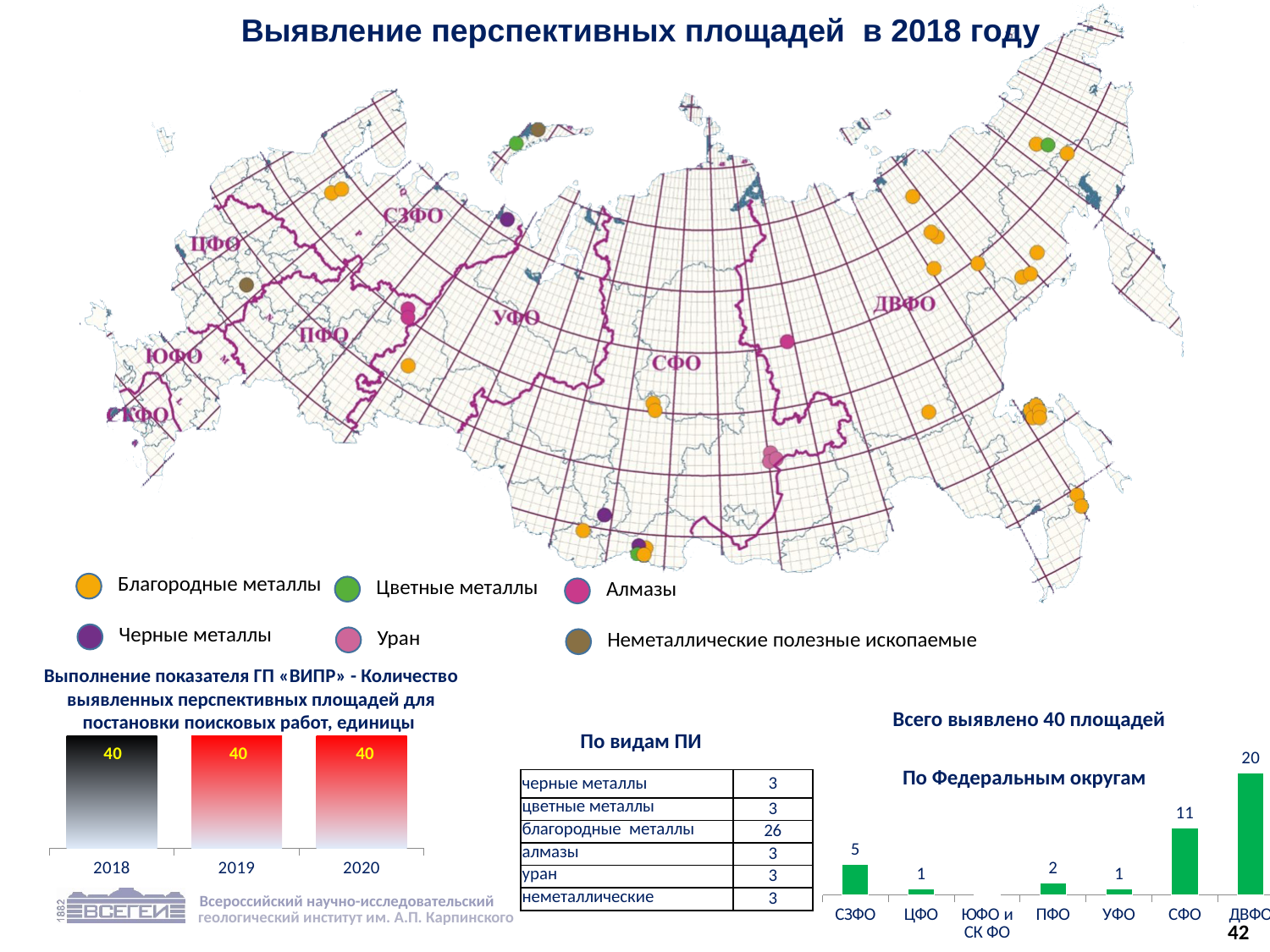
What type of chart is 'По Федеральным округам'? bar chart In the chart 'По Федеральным округам', which is larger, the value for ПФО or the value for УФО? ПФО How many years are shown on the x axis of the chart 'Выполнение показателя ГП «ВИПР»' at the bottom left? 3 In the chart 'По Федеральным округам', which federal district has the highest value? ДВФО In the chart 'Выполнение показателя ГП «ВИПР»' at the bottom left, do the values rise, fall or stay the same from 2018 to 2020? stay the same How many federal district categories are shown on the x axis of the chart 'По Федеральным округам'? 7 In the chart 'По Федеральным округам', what is the value for СФО? 11 In the chart 'Выполнение показателя ГП «ВИПР»' at the bottom left, what is the value for 2019? 40 In the chart 'По Федеральным округам', what is the difference between the values for СЗФО and ЦФО? 4 In the chart 'По Федеральным округам', what is the value for ДВФО? 20 In the chart 'По Федеральным округам', what is the difference between the values for ДВФО and СФО? 9 In the chart 'По Федеральным округам', what is the value for СЗФО? 5